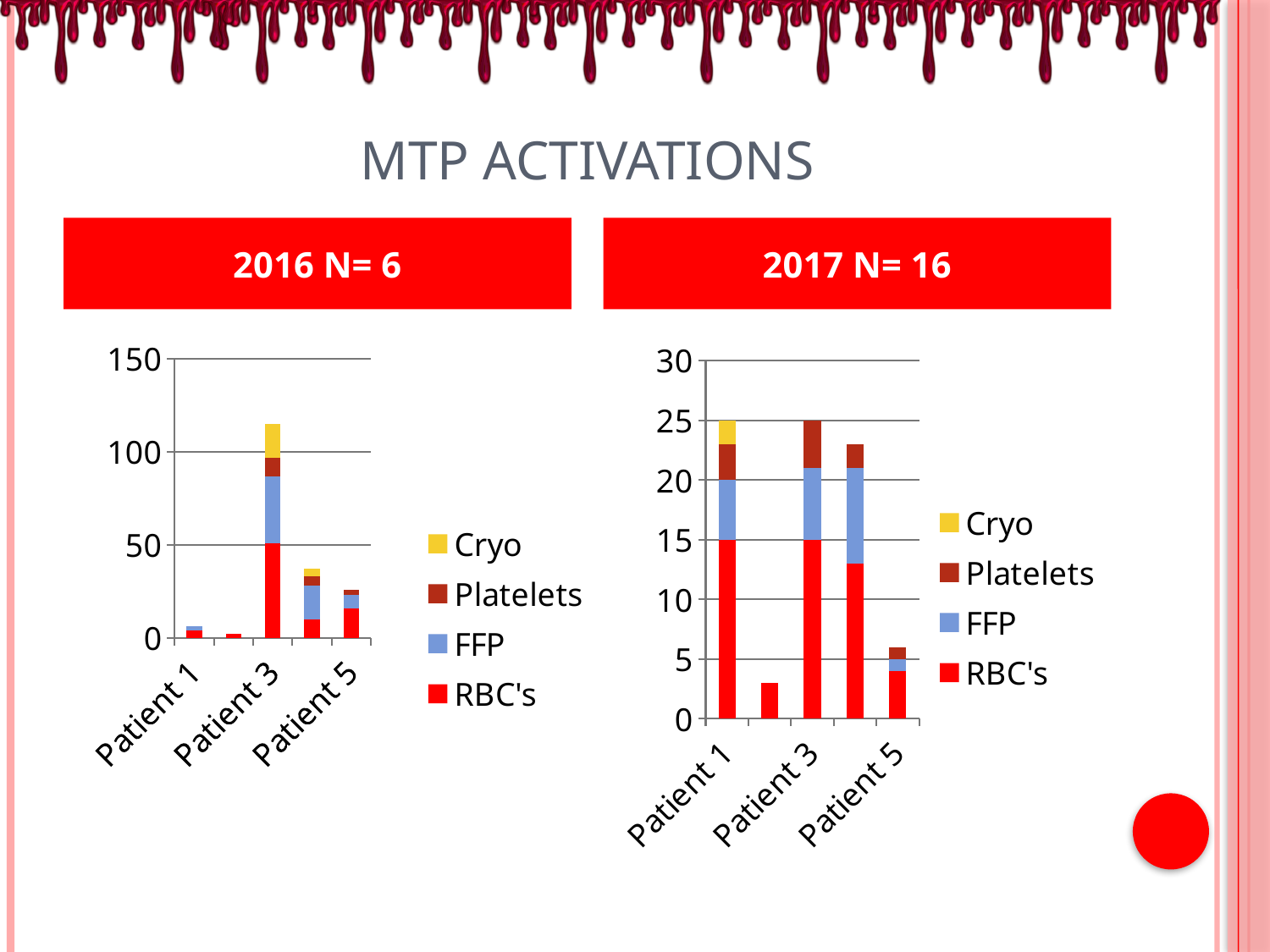
What kind of chart is the 2016 N= 6 chart? Stacked bar chart In the 2017 N= 16 chart, which has the larger total, Patient 1 or Patient 5? Patient 1 In the 2017 N= 16 chart, is the total for Patient 1 greater or less than 20? greater How many bars are plotted in the 2016 N= 6 chart? 5 Which colour represents RBC's in the chart legends? Red What is the title of the slide containing the two charts? MTP ACTIVATIONS In the 2017 N= 16 chart, what is the RBC's value for Patient 1? 15 In the 2016 N= 6 chart, is the total for Patient 5 greater or less than 50? less How many series does the legend of the 2017 N= 16 chart list? 4 In the 2016 N= 6 chart, which patient has the tallest stacked bar? Patient 3 In the 2016 N= 6 chart, is the total for Patient 3 greater or less than 100? greater